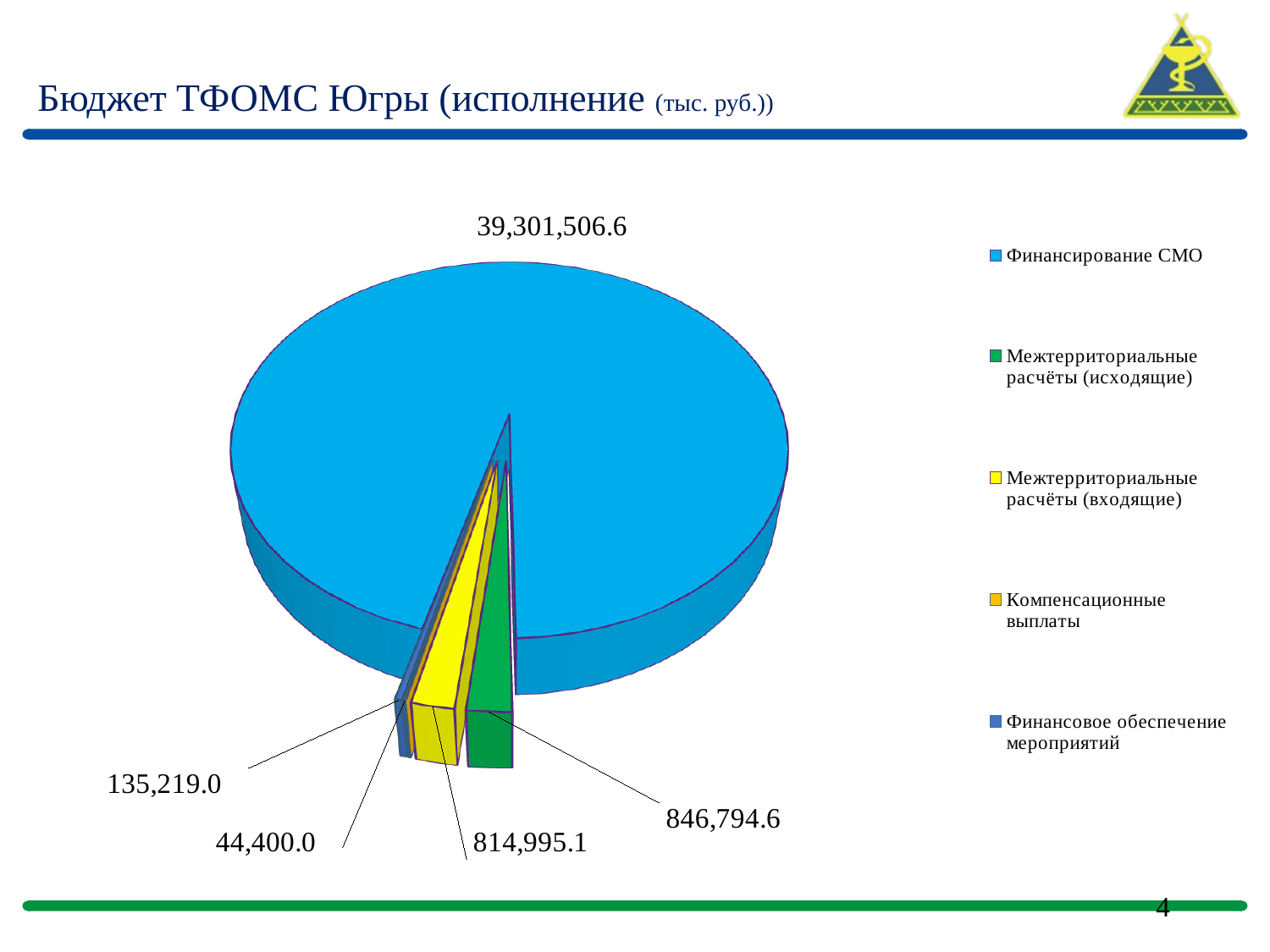
Which category has the smallest value? Компенсационные выплаты What is the value for Финансирование СМО? 39,301,506.6 What is the value for Межтерриториальные расчёты (входящие)? 814,995.1 What is the value for Компенсационные выплаты? 44,400.0 How many entries does the legend list? 5 Which is larger: Межтерриториальные расчёты (исходящие) or Межтерриториальные расчёты (входящие)? Межтерриториальные расчёты (исходящие) What is the value for Финансовое обеспечение мероприятий? 135,219.0 What is the value for Межтерриториальные расчёты (исходящие)? 846,794.6 Which category has the largest slice of the pie? Финансирование СМО What kind of chart is shown on the slide? Pie chart What is the difference between Межтерриториальные расчёты (исходящие) and Межтерриториальные расчёты (входящие)? 31,799.5 How many slices does the pie chart have? 5